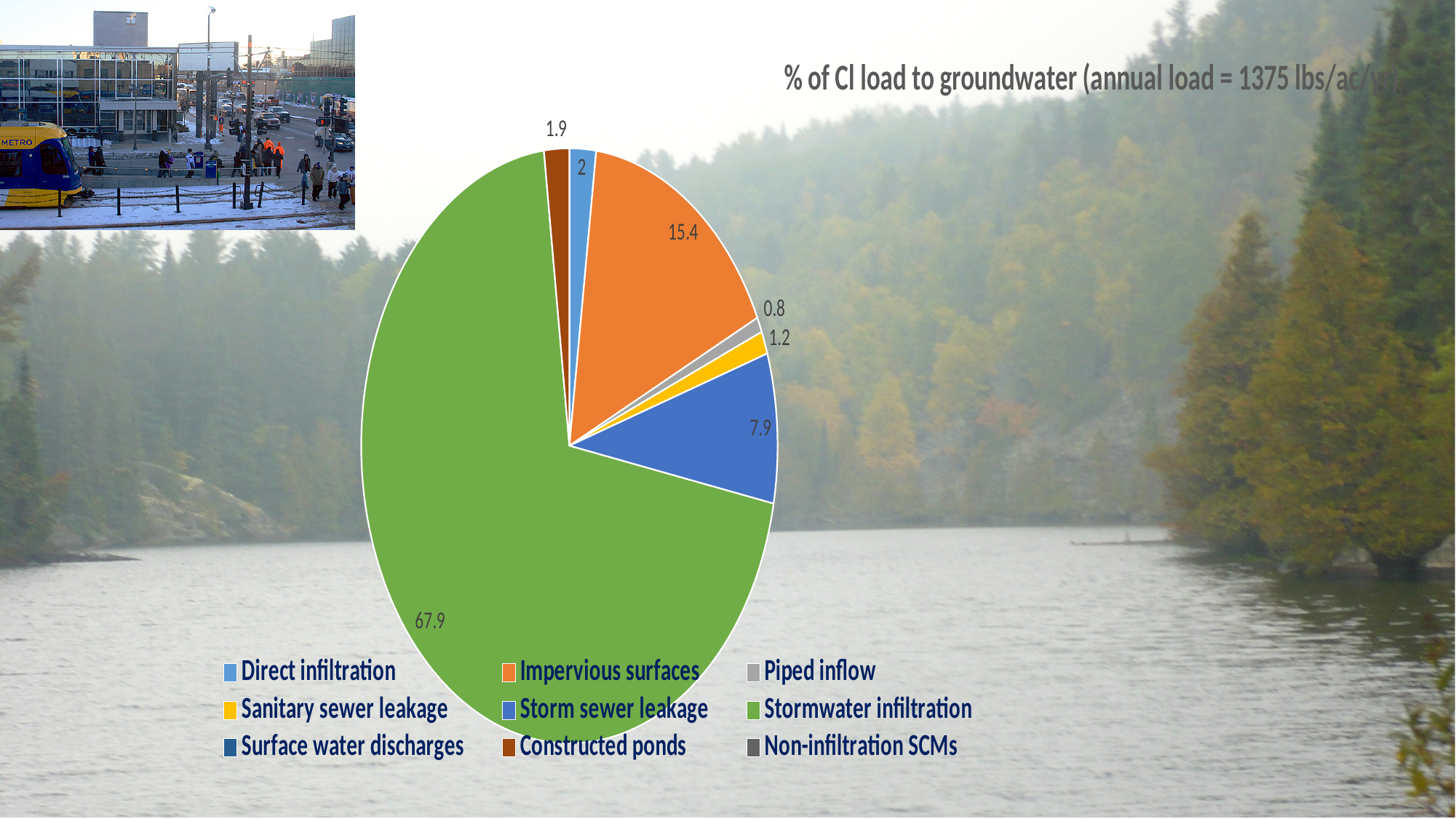
What value is shown for Piped inflow? 0.8 What value is shown for Impervious surfaces? 15.4 What value is shown for Constructed ponds? 1.9 What value is shown for Storm sewer leakage? 7.9 What percentage of the Cl load to groundwater comes from Stormwater infiltration? 67.9 What is the difference between the values for Impervious surfaces and Storm sewer leakage? 7.5 How many categories does the legend list? 9 Which category has the largest slice of the pie? Stormwater infiltration What type of chart is shown on the slide? pie chart What annual load is stated in the chart title? 1375 lbs/ac/yr What value is shown for Direct infiltration? 2 Which is larger, Impervious surfaces or Storm sewer leakage? Impervious surfaces